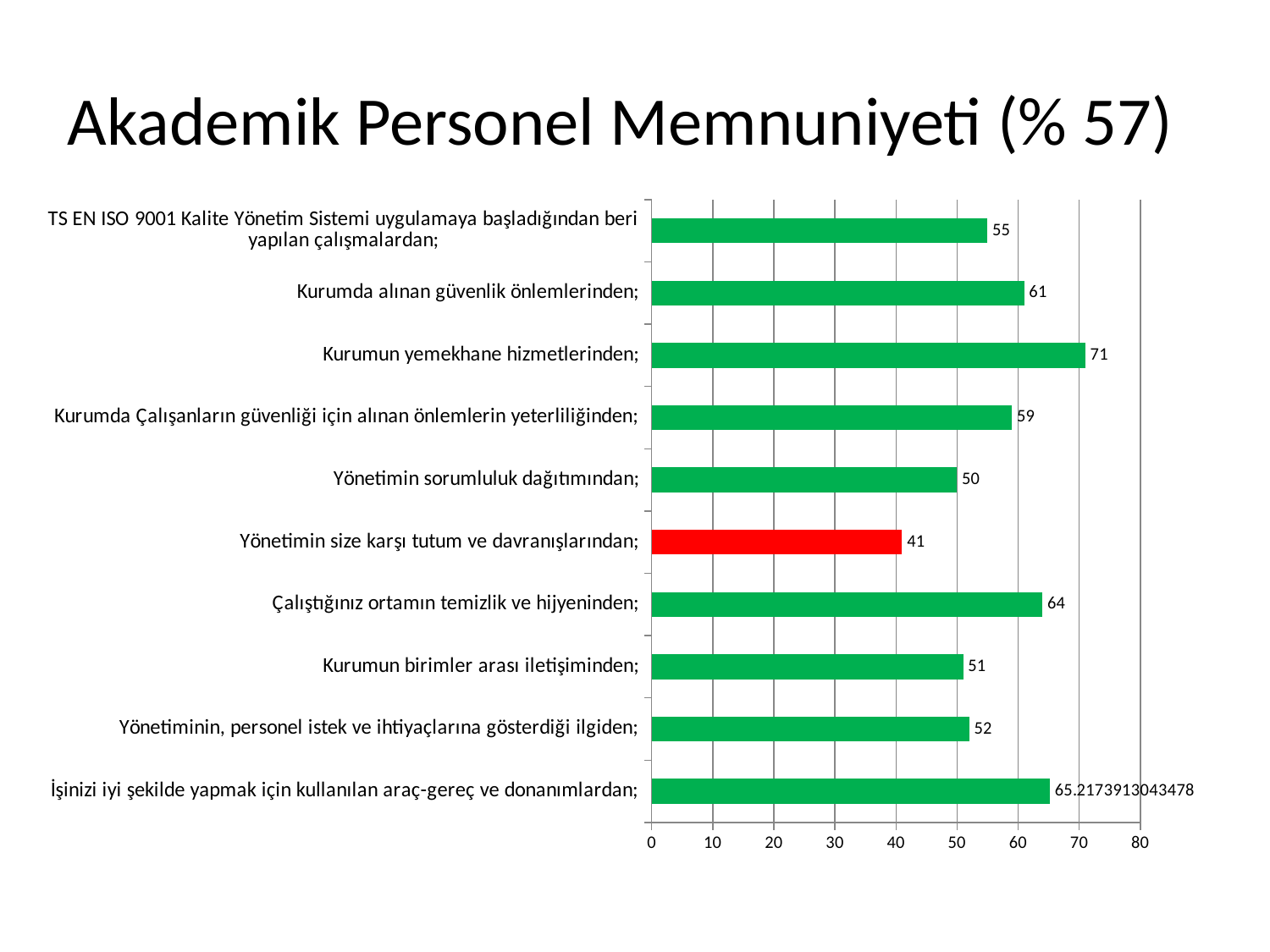
Which category has the lowest value? Yönetimin size karşı tutum ve davranışlarından; What is the title of the slide? Akademik Personel Memnuniyeti (% 57) What is the value for "Kurumda alınan güvenlik önlemlerinden;"? 61 How many categories are shown in the chart? 10 What type of chart is shown on the slide? Bar chart Which category's bar is coloured red? Yönetimin size karşı tutum ve davranışlarından; What is the value for "Çalıştığınız ortamın temizlik ve hijyeninden;"? 64 What is the difference between the values for "Kurumun yemekhane hizmetlerinden;" and "Yönetimin size karşı tutum ve davranışlarından;"? 30 What is the value for "Kurumun yemekhane hizmetlerinden;"? 71 What is the value for "Yönetimin size karşı tutum ve davranışlarından;"? 41 Which category has the highest value? Kurumun yemekhane hizmetlerinden; Which is larger: the value for "Kurumda alınan güvenlik önlemlerinden;" or the value for "Yönetimin sorumluluk dağıtımından;"? Kurumda alınan güvenlik önlemlerinden;